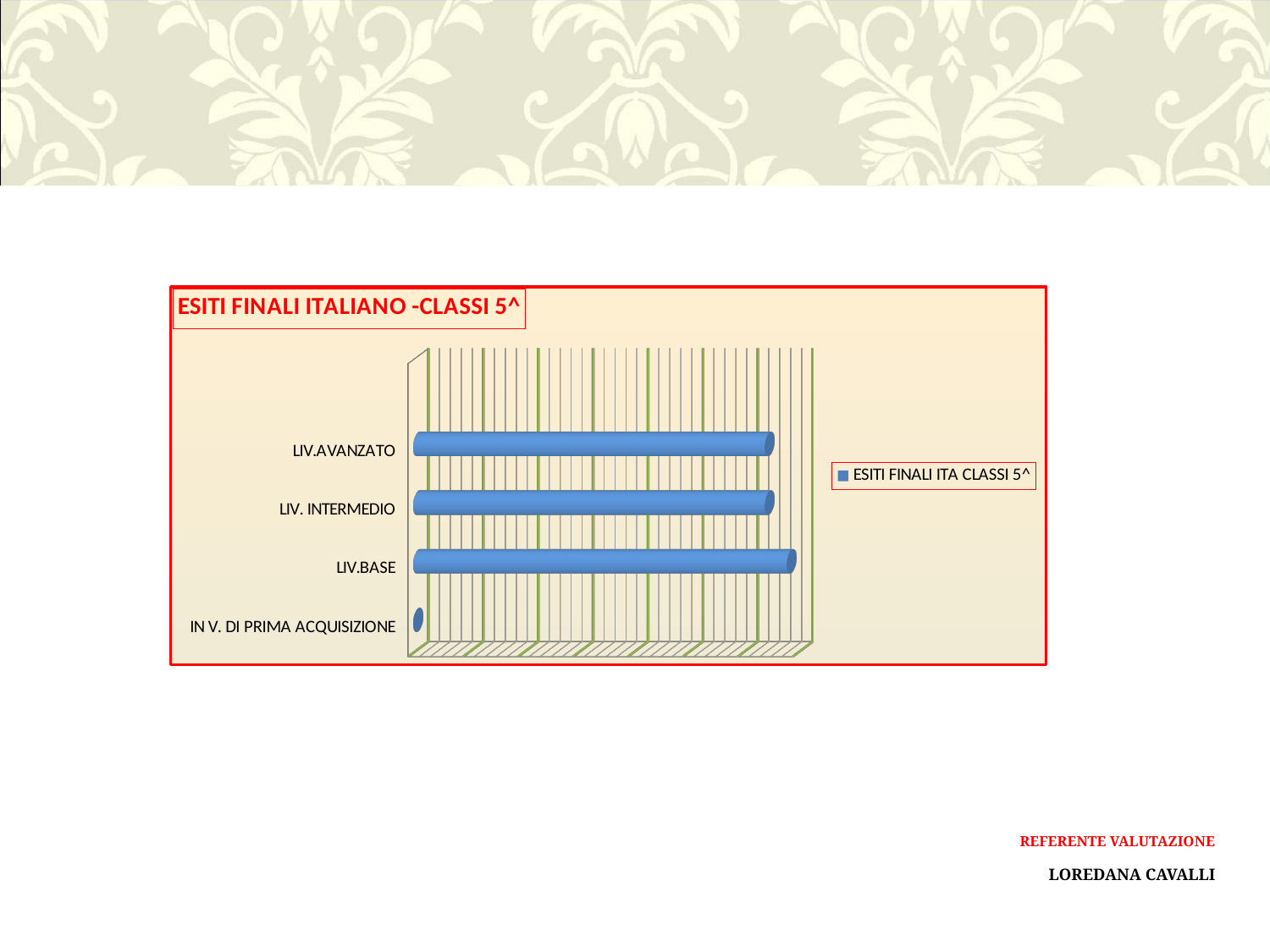
Which is larger, the value for LIV.BASE or the value for IN V. DI PRIMA ACQUISIZIONE? LIV.BASE Which is larger, the value for LIV.AVANZATO or the value for IN V. DI PRIMA ACQUISIZIONE? LIV.AVANZATO What is the title of the chart? ESITI FINALI ITALIANO -CLASSI 5^ What series name is shown in the chart legend? ESITI FINALI ITA CLASSI 5^ Which is larger, the value for LIV. INTERMEDIO or the value for IN V. DI PRIMA ACQUISIZIONE? LIV. INTERMEDIO How many categories are plotted in the chart? 4 Which category has the lowest value in the chart? IN V. DI PRIMA ACQUISIZIONE How many series does the chart legend list? 1 What kind of chart is shown on the slide? Bar chart